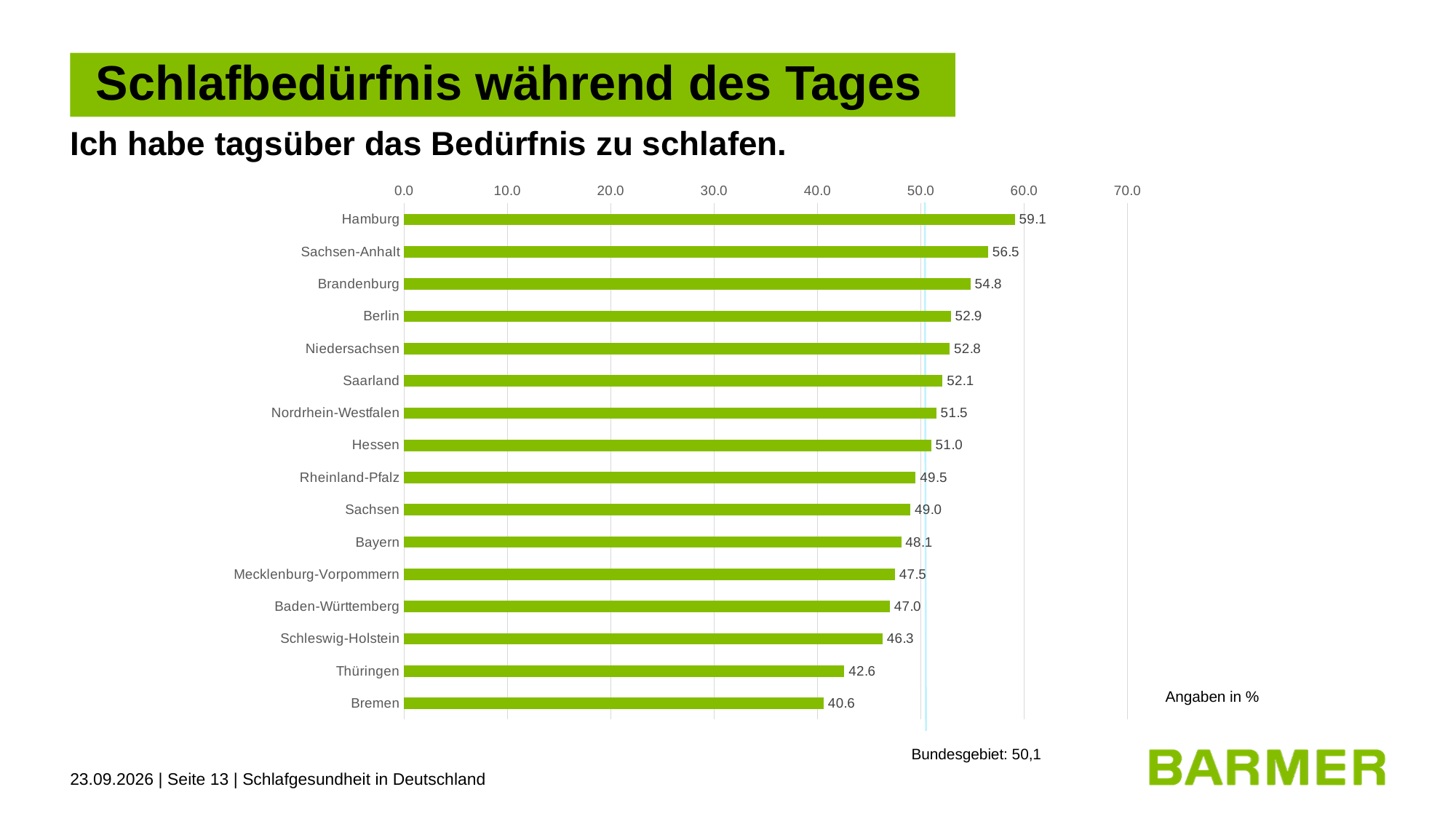
What value is given for Bundesgebiet below the chart? 50,1 How many states are shown in the chart? 16 Which has a larger value, Hessen or Sachsen? Hessen Which state has the highest value? Hamburg What is the difference between the values for Hamburg and Bremen? 18.5 What is the value for Thüringen? 42.6 Which state has the lowest value? Bremen What is the value for Hamburg? 59.1 What kind of chart is shown on the slide? bar chart Is the value for Schleswig-Holstein greater or less than 50.0? less What is the value for Bayern? 48.1 What is the difference between the values for Sachsen-Anhalt and Brandenburg? 1.7